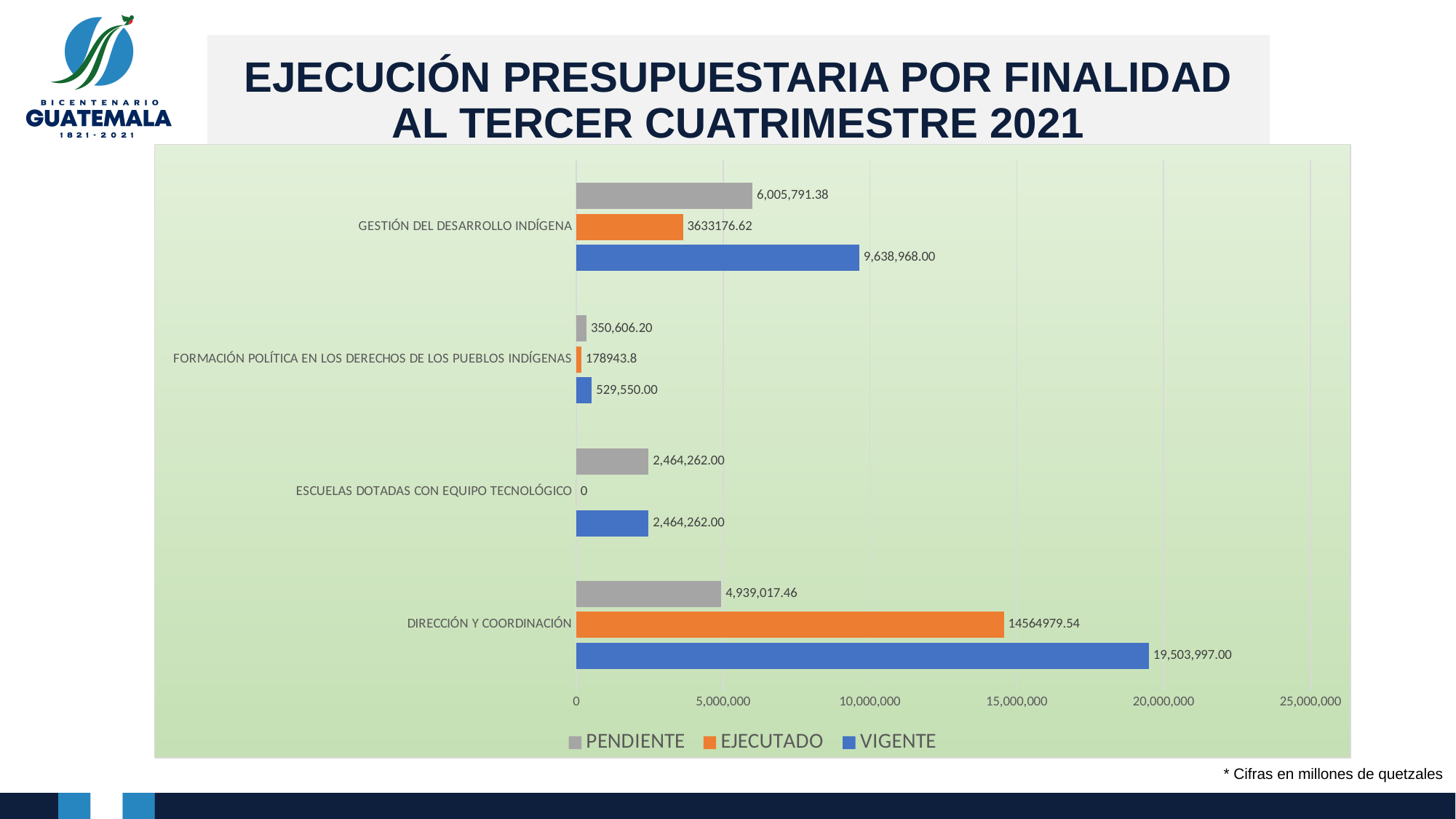
How many categories are shown on the chart? 4 Which is larger: the PENDIENTE value for DIRECCIÓN Y COORDINACIÓN or the PENDIENTE value for GESTIÓN DEL DESARROLLO INDÍGENA? GESTIÓN DEL DESARROLLO INDÍGENA What is the EJECUTADO value for GESTIÓN DEL DESARROLLO INDÍGENA? 3633176.62 How many series does the legend list? 3 What is the VIGENTE value for DIRECCIÓN Y COORDINACIÓN? 19,503,997.00 Which category has the lowest PENDIENTE value? FORMACIÓN POLÍTICA EN LOS DERECHOS DE LOS PUEBLOS INDÍGENAS What is the difference between the VIGENTE and PENDIENTE values for GESTIÓN DEL DESARROLLO INDÍGENA? 3,633,176.62 Is the EJECUTADO value for DIRECCIÓN Y COORDINACIÓN greater or less than 15,000,000? less What is the PENDIENTE value for FORMACIÓN POLÍTICA EN LOS DERECHOS DE LOS PUEBLOS INDÍGENAS? 350,606.20 What kind of chart is shown on the slide? bar chart Which category has the highest VIGENTE value? DIRECCIÓN Y COORDINACIÓN What is the EJECUTADO value for ESCUELAS DOTADAS CON EQUIPO TECNOLÓGICO? 0